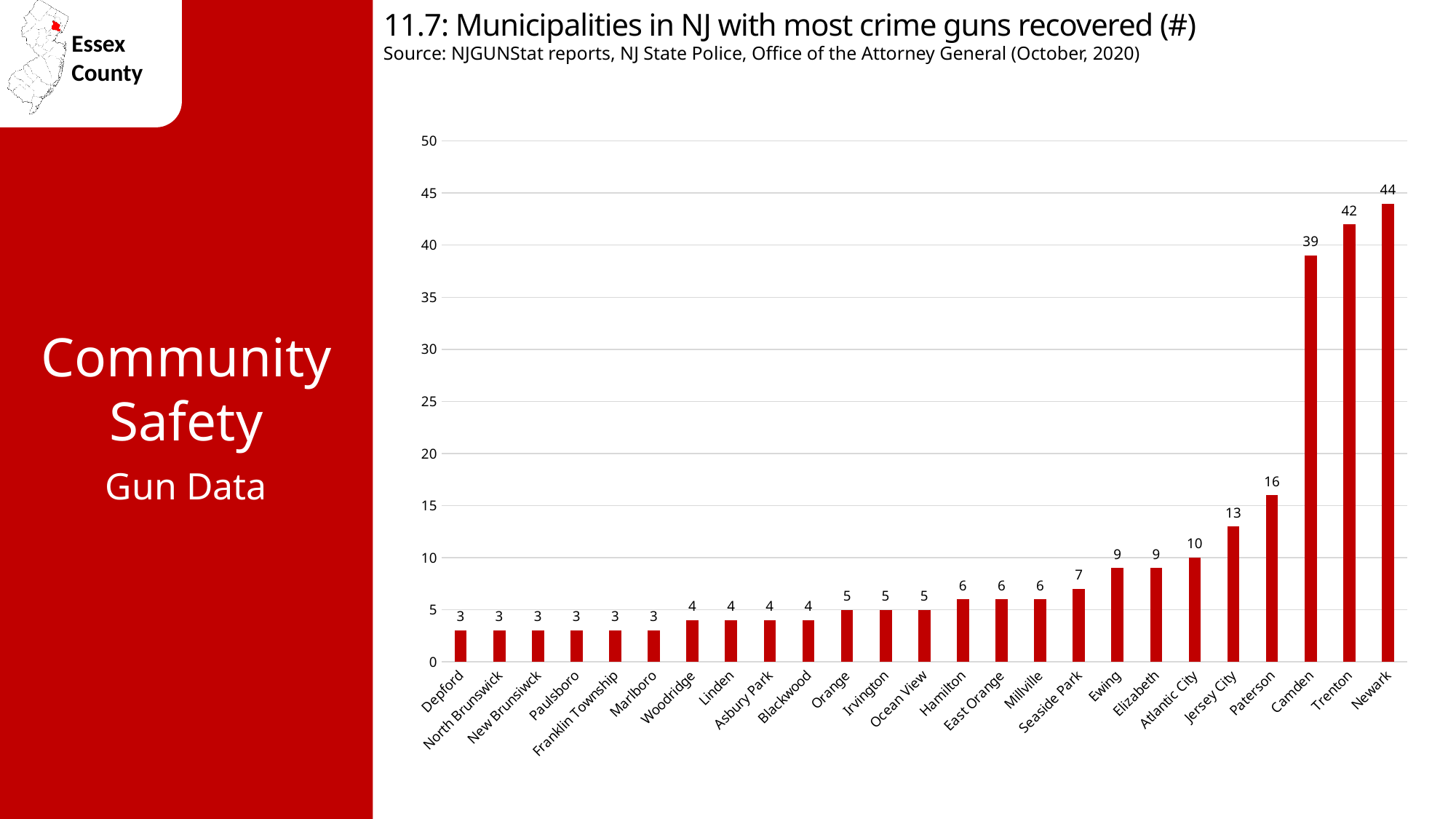
How many crime guns were recovered in Newark? 44 How many crime guns were recovered in Paterson? 16 Which is larger, the value for Camden or the value for Paterson? Camden Do the values rise or fall moving from left to right along the x axis? Rise How many municipalities are shown on the chart? 25 What is the difference between the values for Jersey City and Atlantic City? 3 What is the difference between the values for Newark and Trenton? 2 What kind of chart is shown on the slide? Bar chart Is the value for Trenton greater or less than 40? greater What is the value shown for East Orange? 6 Which municipality has the highest number of crime guns recovered? Newark What is the value shown for Camden? 39